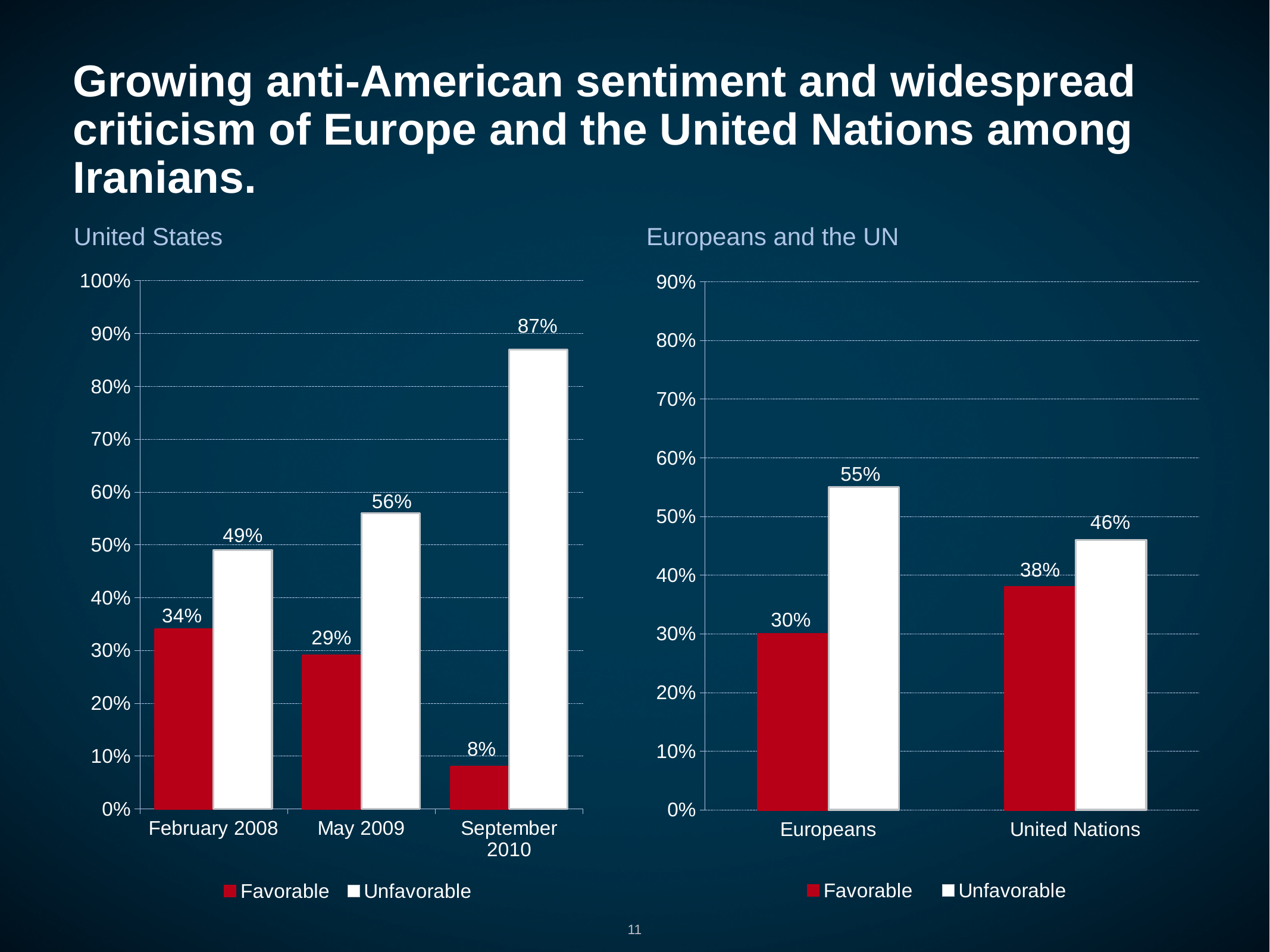
In the 'Europeans and the UN' chart, what is the Unfavorable value for Europeans? 55% In the 'United States' chart, which category has the highest Unfavorable value? September 2010 In the 'Europeans and the UN' chart, what is the Favorable value for United Nations? 38% In the 'United States' chart, what is the difference between the Unfavorable and Favorable values for May 2009? 27% How many series does the legend of the 'Europeans and the UN' chart list? 2 In the 'Europeans and the UN' chart, what is the difference between the Unfavorable values for Europeans and United Nations? 9% In the 'United States' chart, do the Favorable values rise or fall from February 2008 to September 2010? fall In the 'Europeans and the UN' chart, which is larger: the Favorable value for Europeans or the Favorable value for United Nations? United Nations In the 'United States' chart, what is the Favorable value for February 2008? 34% In the 'United States' chart, what is the Unfavorable value for September 2010? 87% How many categories are shown on the x axis of the 'United States' chart? 3 In the 'United States' chart, which category has the lowest Favorable value? September 2010